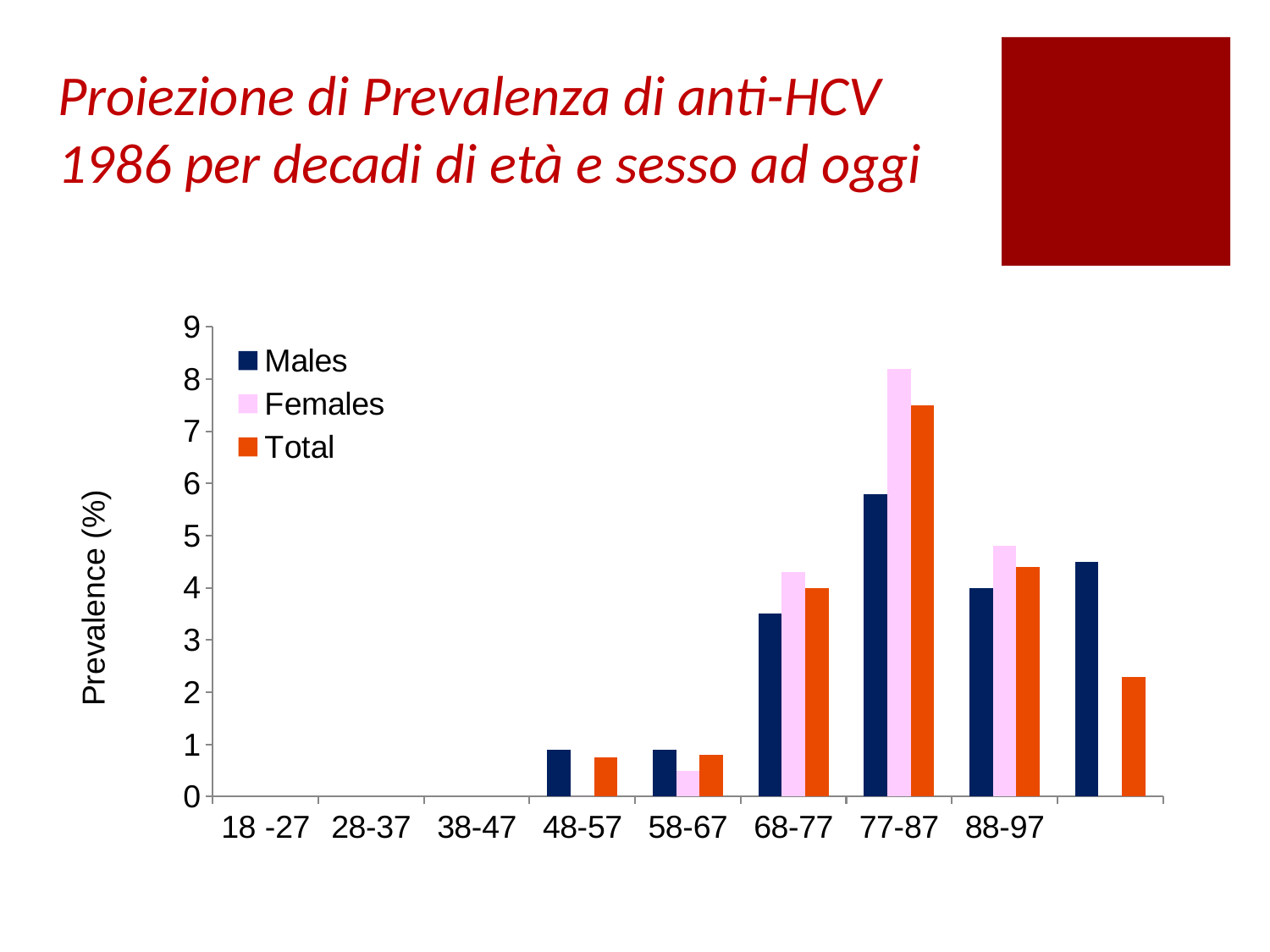
Is the Males value for the 68-77 age group greater or less than 3? greater In the 58-67 age group, which is larger, the Males value or the Females value? Males What kind of chart is shown on the slide? bar chart Which age group has the highest Total prevalence? 77-87 Is the Females value for the 58-67 age group greater or less than 1? less Is the Males value for the 77-87 age group greater or less than 5? greater In the 77-87 age group, which is larger, the Males value or the Females value? Females In the 77-87 age group, which series has the tallest bar? Females How many series does the legend list? 3 Which series are listed in the legend? Males, Females, Total What is the label of the vertical axis? Prevalence (%)